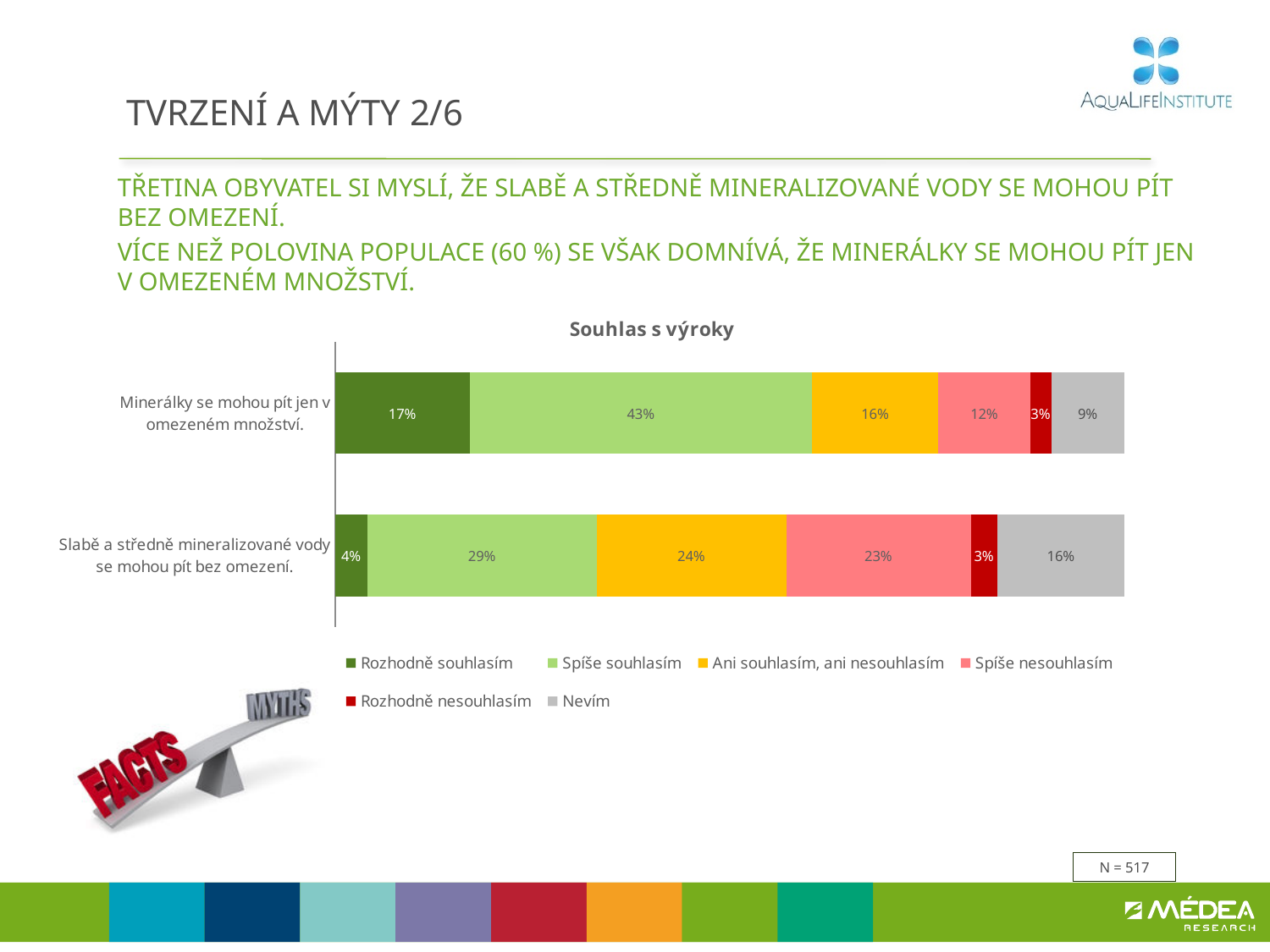
Which series has the lowest value for "Minerálky se mohou pít jen v omezeném množství."? Rozhodně nesouhlasím Which series has the highest value for "Slabě a středně mineralizované vody se mohou pít bez omezení."? Spíše souhlasím How many series does the chart legend list? 6 How many categories (statements) are plotted in the chart? 2 What is the difference between the "Rozhodně souhlasím" values for the two statements? 13% What is the value of "Nevím" for "Slabě a středně mineralizované vody se mohou pít bez omezení."? 16% What is the value of "Rozhodně souhlasím" for "Slabě a středně mineralizované vody se mohou pít bez omezení."? 4% What type of chart is shown on the slide? Stacked bar chart What is the title of the chart? Souhlas s výroky What is the value of "Spíše nesouhlasím" for "Minerálky se mohou pít jen v omezeném množství."? 12% What is the value of "Spíše souhlasím" for "Minerálky se mohou pít jen v omezeném množství."? 43% Which statement has the larger "Ani souhlasím, ani nesouhlasím" value? Slabě a středně mineralizované vody se mohou pít bez omezení.